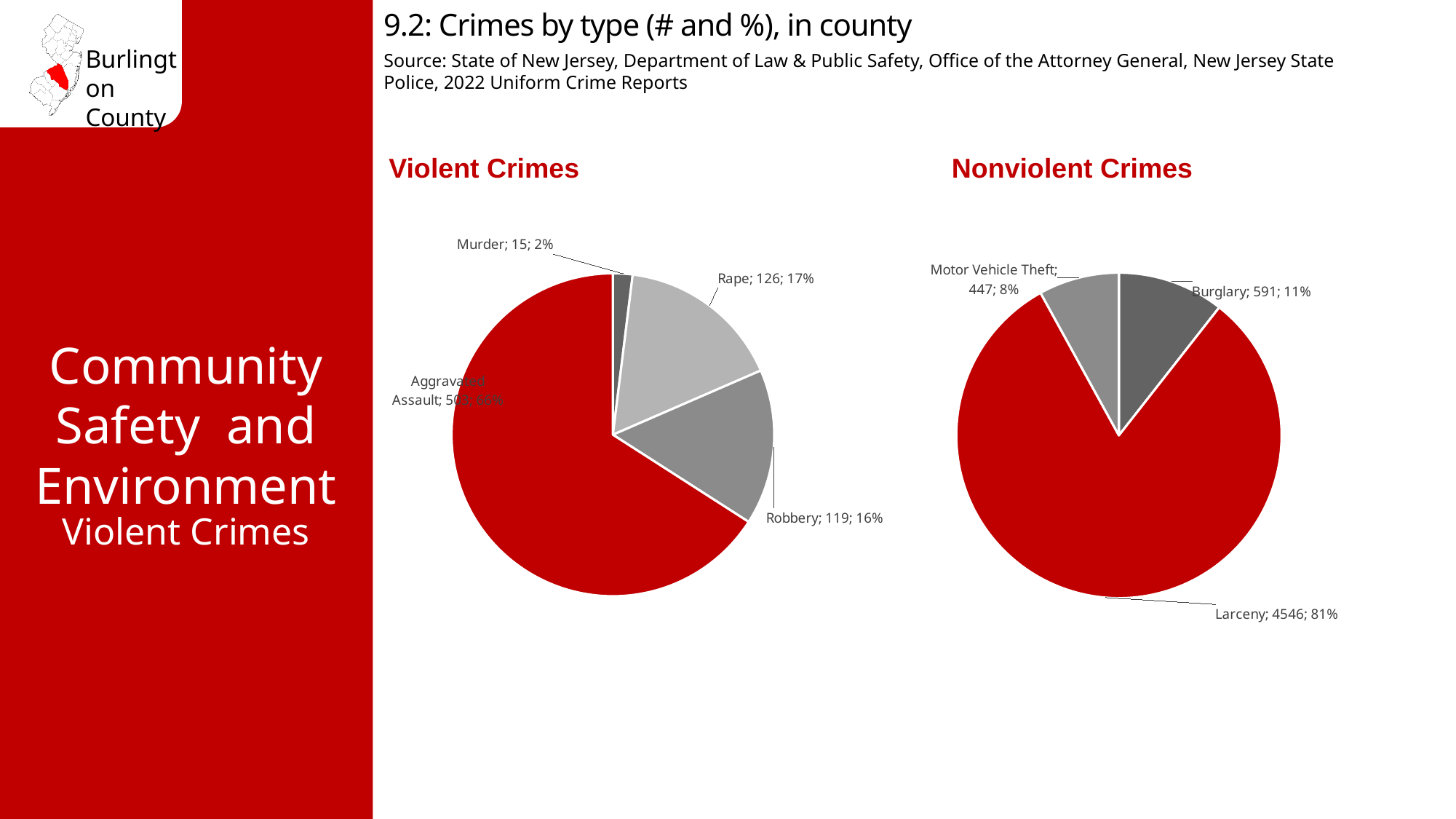
In the Violent Crimes chart, what is the value for Rape? 126 In the Violent Crimes chart, which category has the largest slice? Aggravated Assault In the Violent Crimes chart, which category has the smallest slice? Murder In the Violent Crimes chart, how many murders are shown? 15 In the Nonviolent Crimes chart, what share of the pie is Motor Vehicle Theft? 8% What type of chart is the Violent Crimes chart? Pie chart In the Violent Crimes chart, what share of the pie is Robbery? 16% In the Nonviolent Crimes chart, what is the difference between the Burglary and Motor Vehicle Theft counts? 144 In the Nonviolent Crimes chart, what is the value for Larceny? 4546 In the Nonviolent Crimes chart, which is larger, Burglary or Motor Vehicle Theft? Burglary In the Violent Crimes chart, what is the difference between the Rape and Robbery counts? 7 How many categories does the Nonviolent Crimes chart show? 3